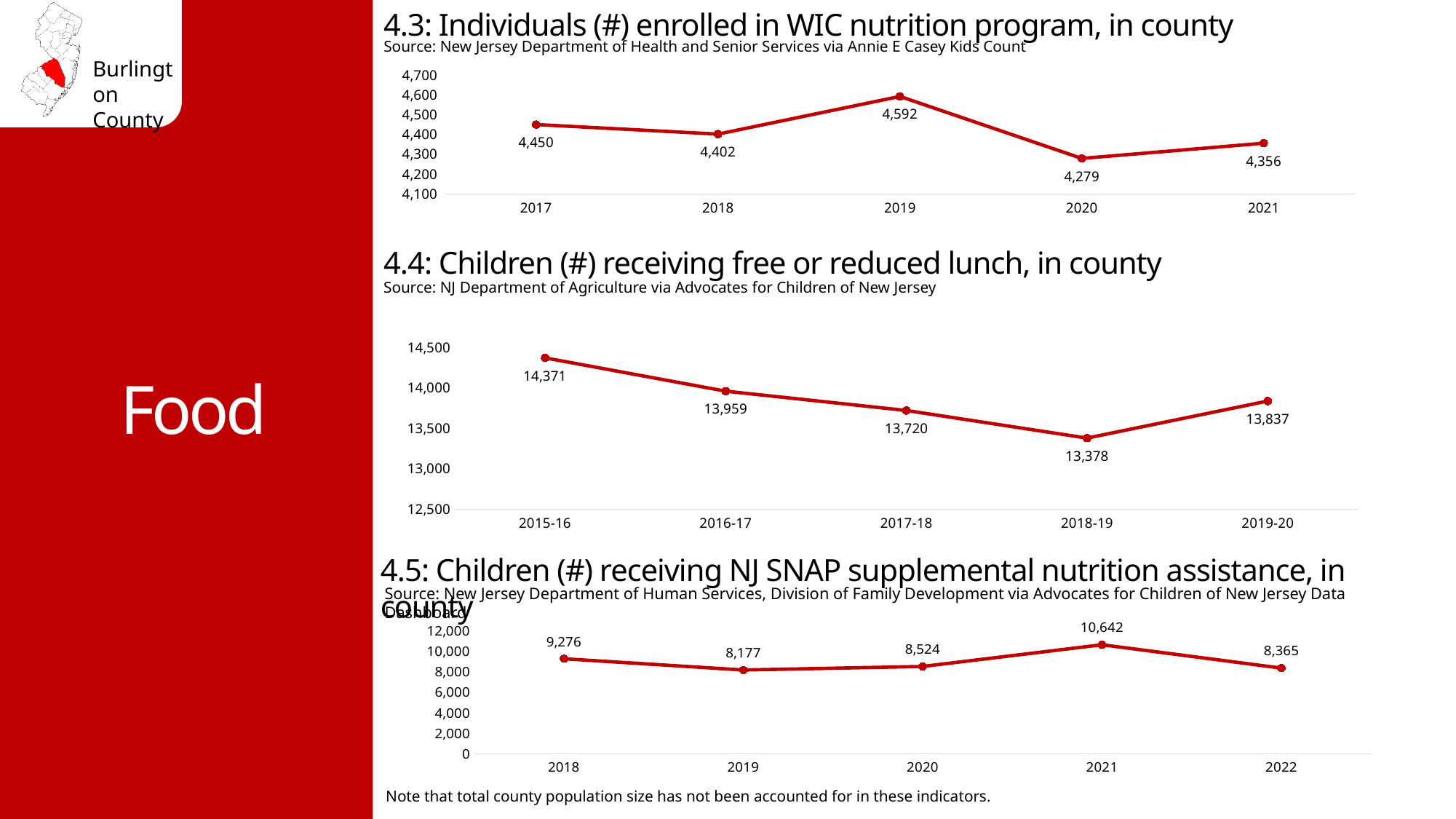
In the chart '4.3: Individuals (#) enrolled in WIC nutrition program, in county', which year has the lowest value? 2020 In the chart '4.3: Individuals (#) enrolled in WIC nutrition program, in county', what is the value for 2019? 4,592 In the chart '4.4: Children (#) receiving free or reduced lunch, in county', what is the difference between the 2015-16 and 2019-20 values? 534 In the chart '4.4: Children (#) receiving free or reduced lunch, in county', what is the value for 2018-19? 13,378 In the chart '4.5: Children (#) receiving NJ SNAP supplemental nutrition assistance, in county', which is larger, the value for 2018 or the value for 2022? 2018 In the chart '4.5: Children (#) receiving NJ SNAP supplemental nutrition assistance, in county', which year has the lowest value? 2019 In the chart '4.5: Children (#) receiving NJ SNAP supplemental nutrition assistance, in county', what is the value for 2021? 10,642 In the chart '4.4: Children (#) receiving free or reduced lunch, in county', which school year has the highest value? 2015-16 In the chart '4.3: Individuals (#) enrolled in WIC nutrition program, in county', how many years are plotted? 5 In the chart '4.4: Children (#) receiving free or reduced lunch, in county', do values rise or fall from 2015-16 to 2018-19? fall In the chart '4.3: Individuals (#) enrolled in WIC nutrition program, in county', what is the difference between the 2019 and 2020 values? 313 What type of chart is '4.5: Children (#) receiving NJ SNAP supplemental nutrition assistance, in county'? line chart